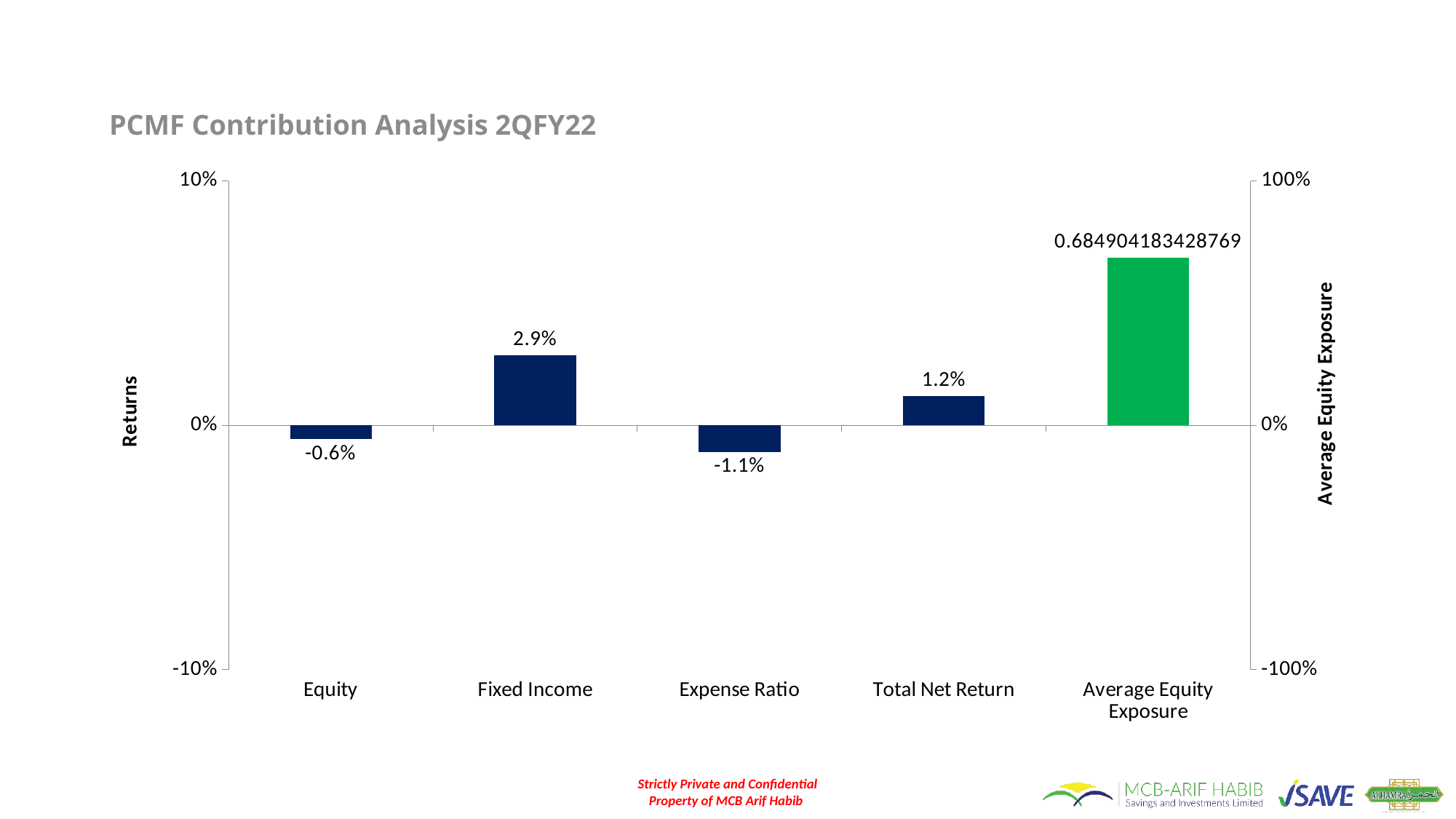
Among Equity, Fixed Income, Expense Ratio and Total Net Return, which category has the lowest value? Expense Ratio What is the value for Fixed Income? 2.9% What is the value for Expense Ratio? -1.1% How many categories are shown on the x axis? 5 What is the title of the chart? PCMF Contribution Analysis 2QFY22 What data label is shown on the Average Equity Exposure bar? 0.684904183428769 What is the value for Total Net Return? 1.2% Which is larger, the value for Equity or the value for Expense Ratio? Equity Among Equity, Fixed Income, Expense Ratio and Total Net Return, which category has the highest value? Fixed Income What kind of chart is shown on the slide? Bar chart What is the value for Equity? -0.6% What is the difference between the Fixed Income value and the Total Net Return value? 1.7%